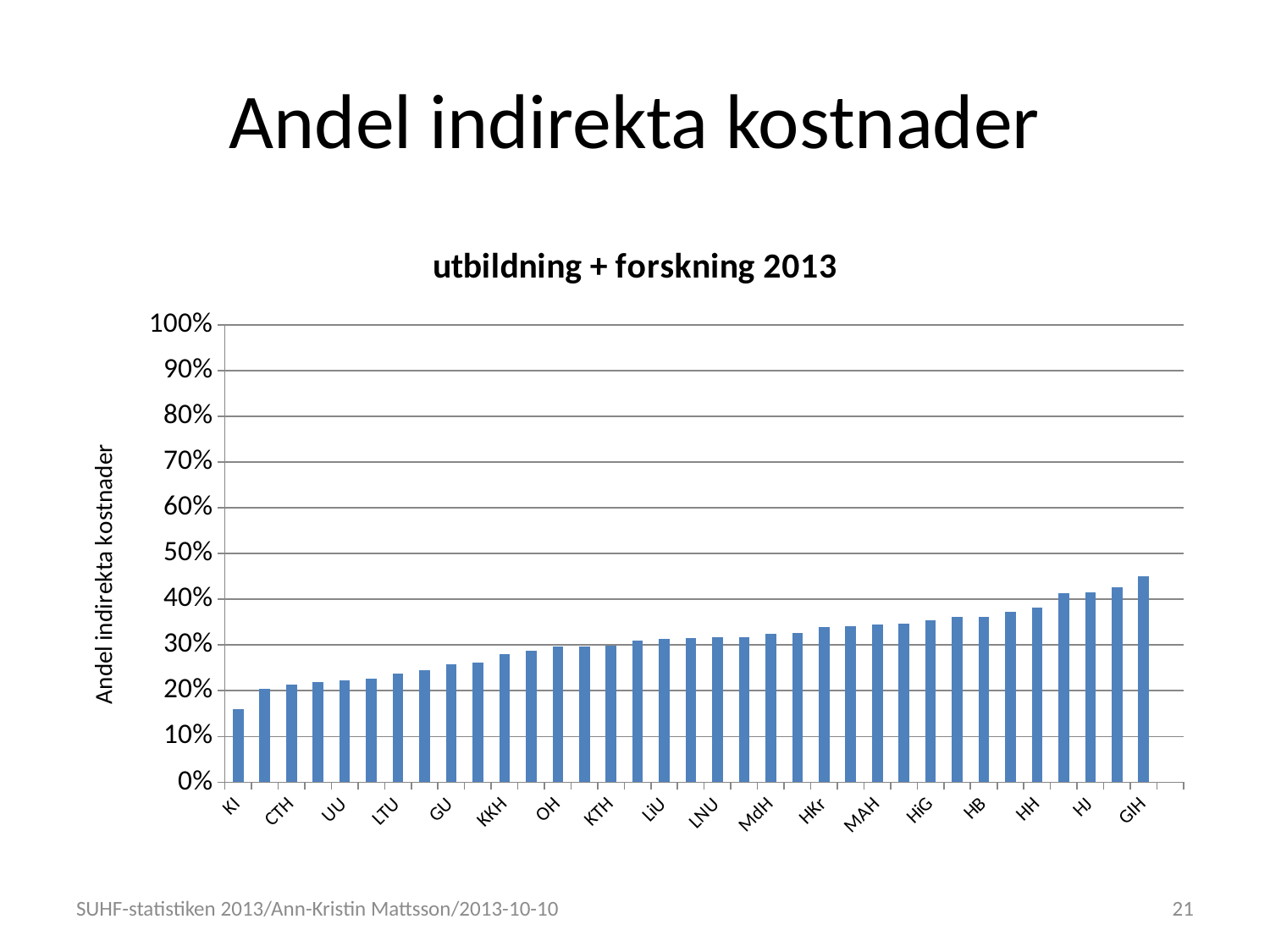
Is the value for GIH greater or less than 40%? greater Which is larger, the value for HH or the value for GU? HH Is the value for HH greater or less than 30%? greater Do the values rise or fall from left to right along the x axis? rise Is the value for KKH greater or less than 30%? less Which category has the lowest value? KI Which category has the highest value? GIH What is the title of the chart? utbildning + forskning 2013 What kind of chart is shown on the slide? bar chart